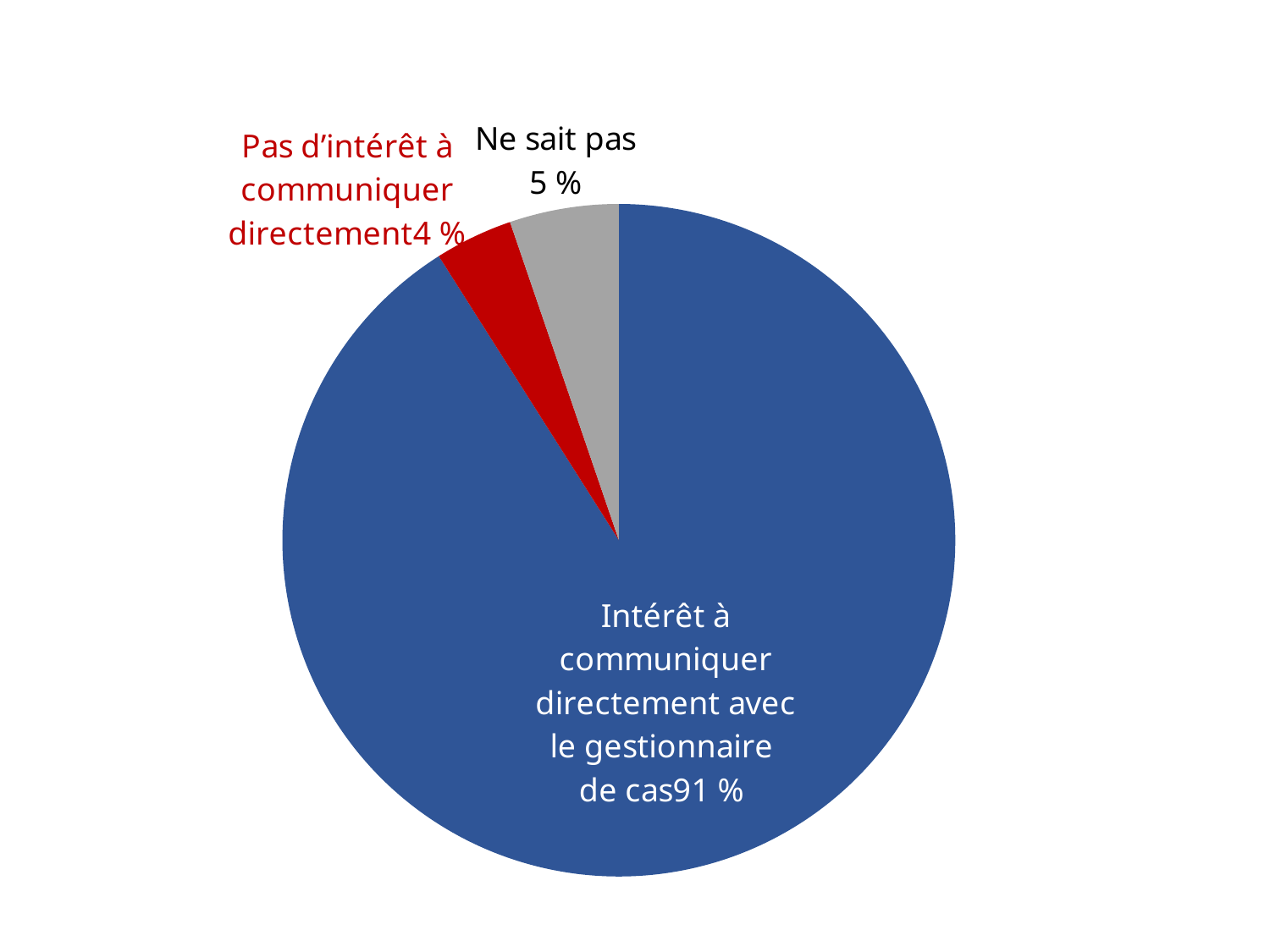
Which is larger: the "Ne sait pas" slice or the "Pas d'intérêt à communiquer directement" slice? Ne sait pas What share of the pie is labelled "Ne sait pas"? 5 % What colour is the "Ne sait pas" slice? grey What share of the pie is labelled "Intérêt à communiquer directement avec le gestionnaire de cas"? 91 % What kind of chart is shown on the slide? pie chart Which slice of the pie chart is the largest? Intérêt à communiquer directement avec le gestionnaire de cas What share of the pie is labelled "Pas d'intérêt à communiquer directement"? 4 % What colour is the "Pas d'intérêt à communiquer directement" slice? red What is the difference in percentage points between the "Intérêt à communiquer directement avec le gestionnaire de cas" slice and the "Ne sait pas" slice? 86 % How many slices does the pie chart have? 3 What is the difference in percentage points between the "Ne sait pas" slice and the "Pas d'intérêt à communiquer directement" slice? 1 % Which slice of the pie chart is the smallest? Pas d'intérêt à communiquer directement